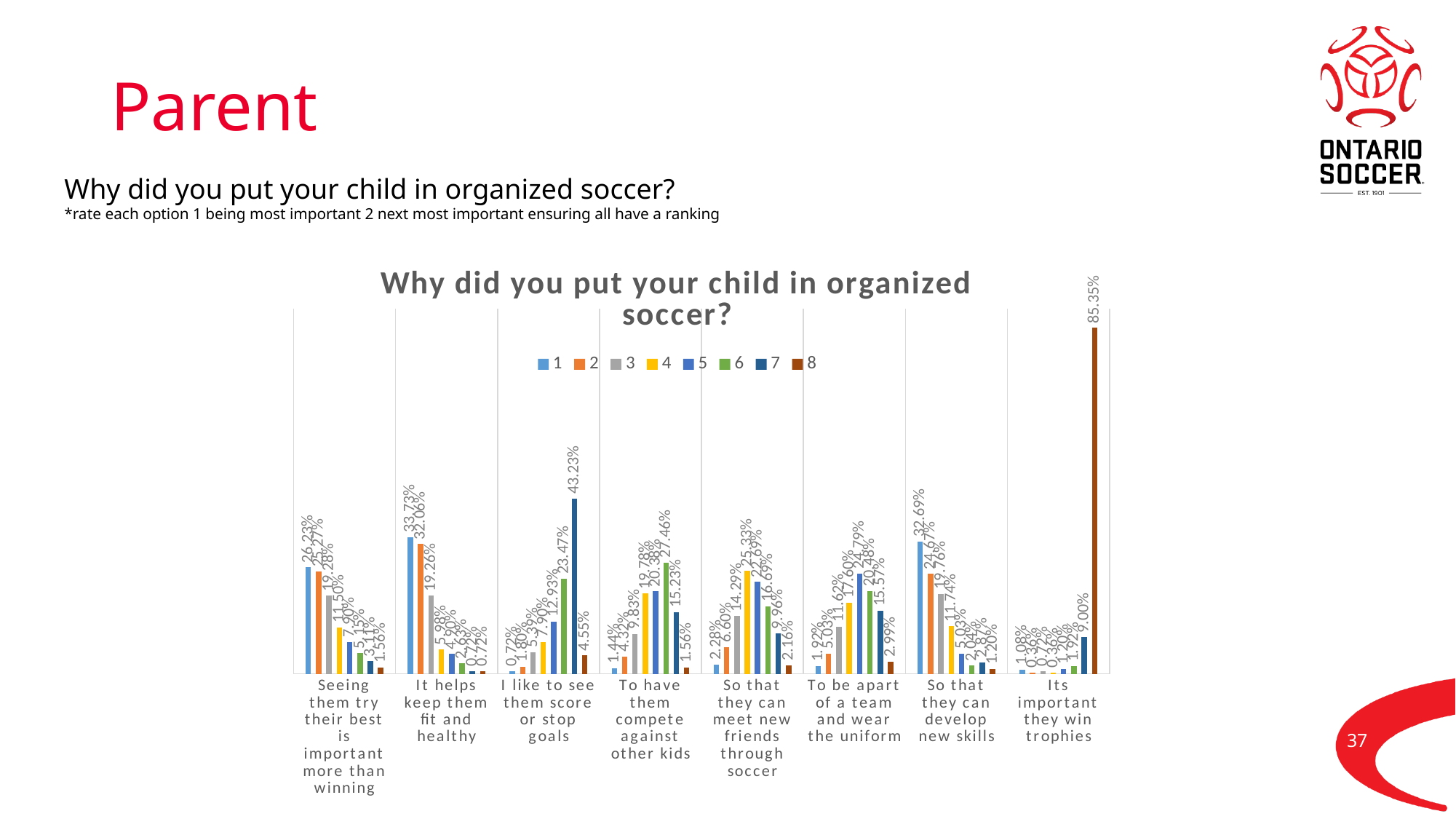
What is the difference between series 8 for "Its important they win trophies" and series 7 for "I like to see them score or stop goals"? 42.12% What is the value for series 8 in the category "Its important they win trophies"? 85.35% What is the value for series 1 in the category "So that they can develop new skills"? 32.69% What is the value for series 7 in the category "I like to see them score or stop goals"? 43.23% What is the value for series 1 in the category "It helps keep them fit and healthy"? 33.73% What kind of chart is shown on the slide? bar chart What is the value for series 8 in the category "I like to see them score or stop goals"? 4.55% Which series has the highest value in the category "Its important they win trophies"? 8 How many categories are shown along the x axis of the chart? 8 Which is larger: series 7 for "I like to see them score or stop goals" or series 6 for "To have them compete against other kids"? series 7 for "I like to see them score or stop goals" How many series does the chart legend list? 8 Which series has the highest value in the category "I like to see them score or stop goals"? 7